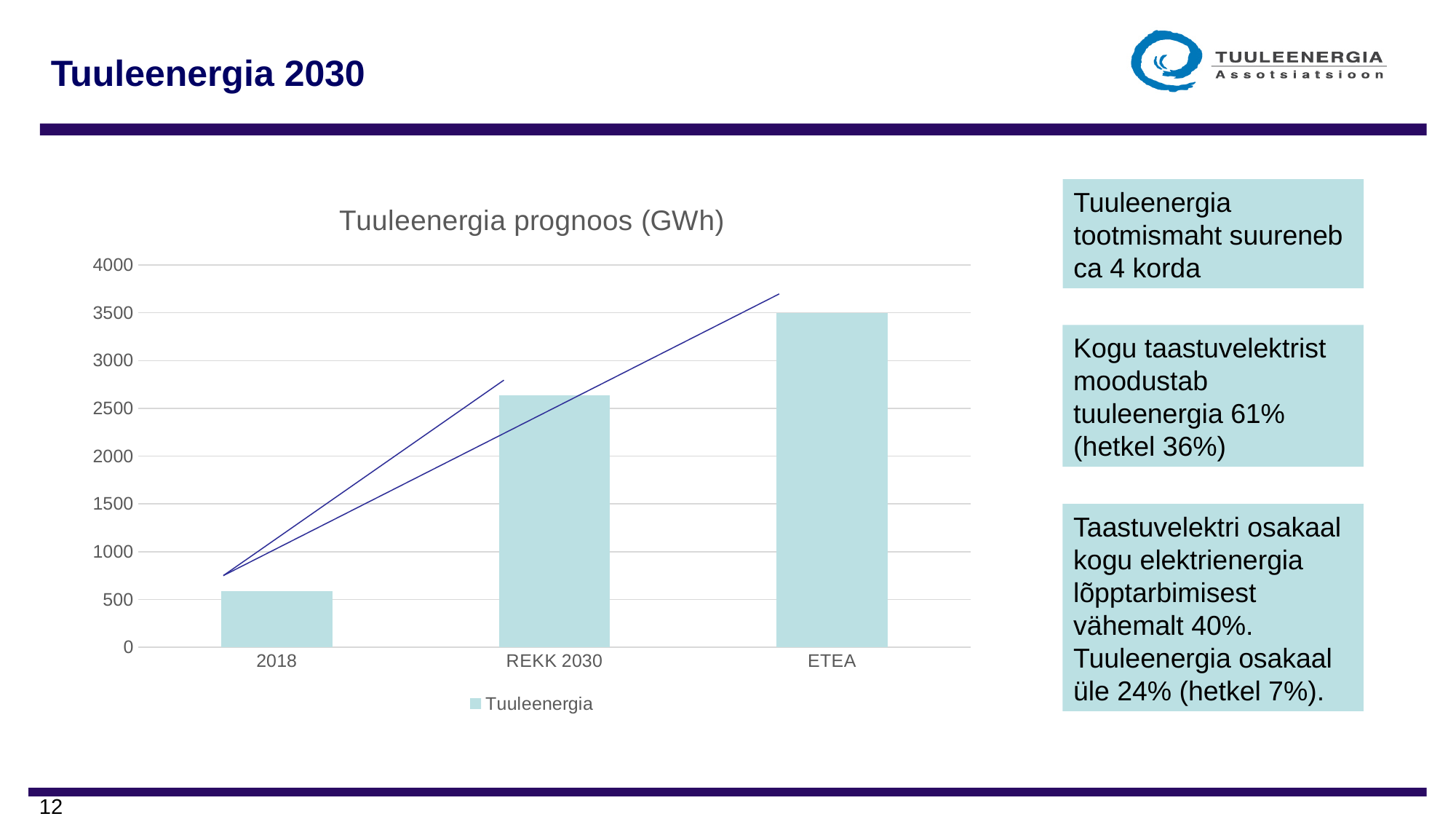
Is the value for REKK 2030 greater or less than 2500? greater Do the values rise or fall from 2018 to ETEA along the x axis? rise What is the name of the series shown in the chart legend? Tuuleenergia How many categories are shown on the x axis of the chart? 3 How many series does the chart legend list? 1 Which is larger, the value for REKK 2030 or the value for 2018? REKK 2030 What kind of chart is shown on the slide? bar chart Is the value for 2018 greater or less than 1000? less Is the value for ETEA greater or less than 3000? greater What is the title of the chart? Tuuleenergia prognoos (GWh) Which category has the highest value in the chart? ETEA Which category has the lowest value in the chart? 2018